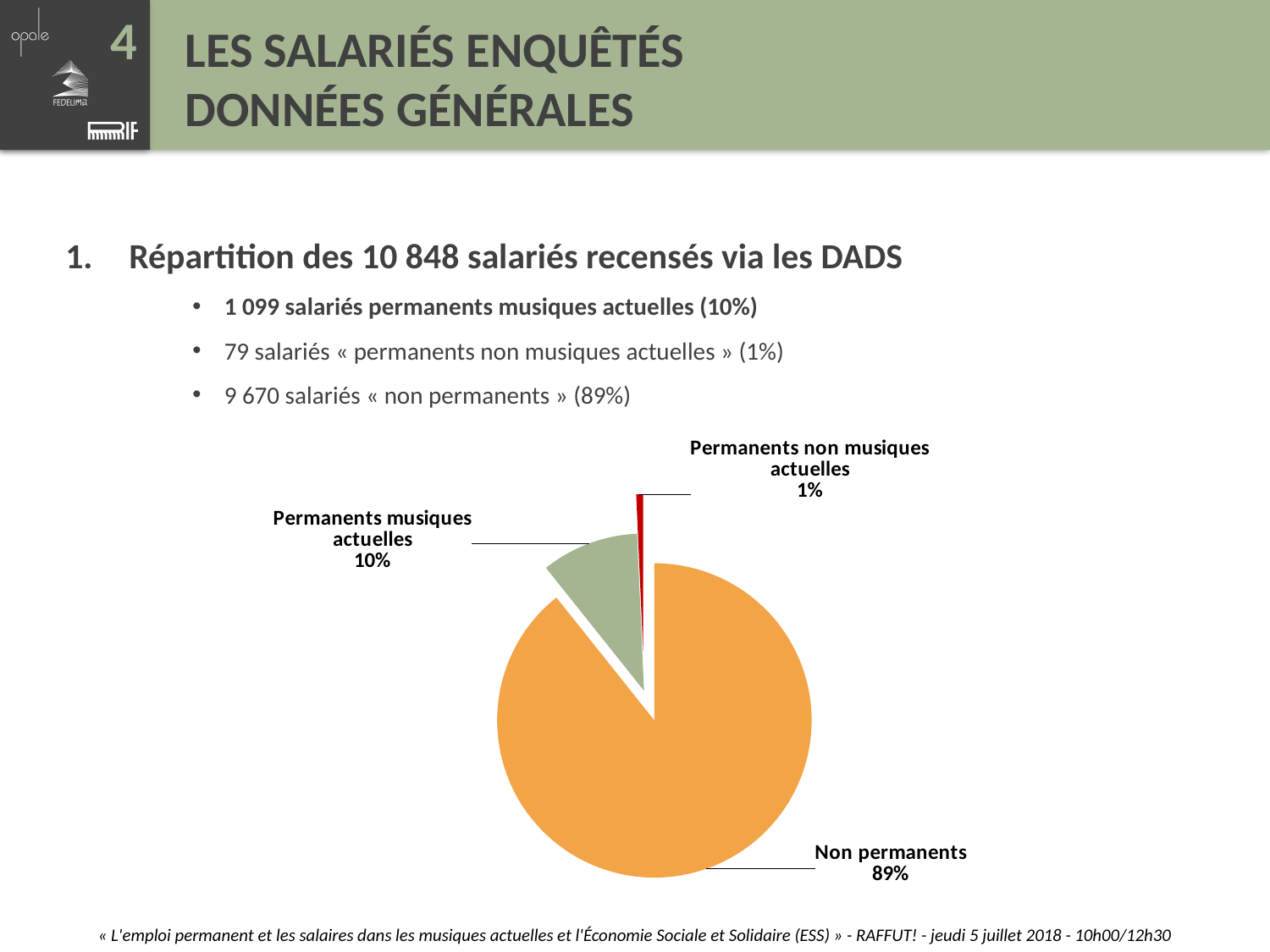
How many slices does the pie chart have? 3 Which is larger: the "Permanents musiques actuelles" slice or the "Permanents non musiques actuelles" slice? Permanents musiques actuelles What is the difference in percentage points between the "Permanents musiques actuelles" slice and the "Permanents non musiques actuelles" slice? 9 Which slice of the pie chart is the smallest? Permanents non musiques actuelles What share of the pie does "Non permanents" represent? 89% What share of the pie does "Permanents non musiques actuelles" represent? 1% What colour is the "Permanents non musiques actuelles" slice of the pie chart? red What share of the pie does "Permanents musiques actuelles" represent? 10% What colour is the "Non permanents" slice of the pie chart? orange What is the difference in percentage points between the "Non permanents" slice and the "Permanents musiques actuelles" slice? 79 What kind of chart is shown on the slide? pie chart Which slice of the pie chart is the largest? Non permanents